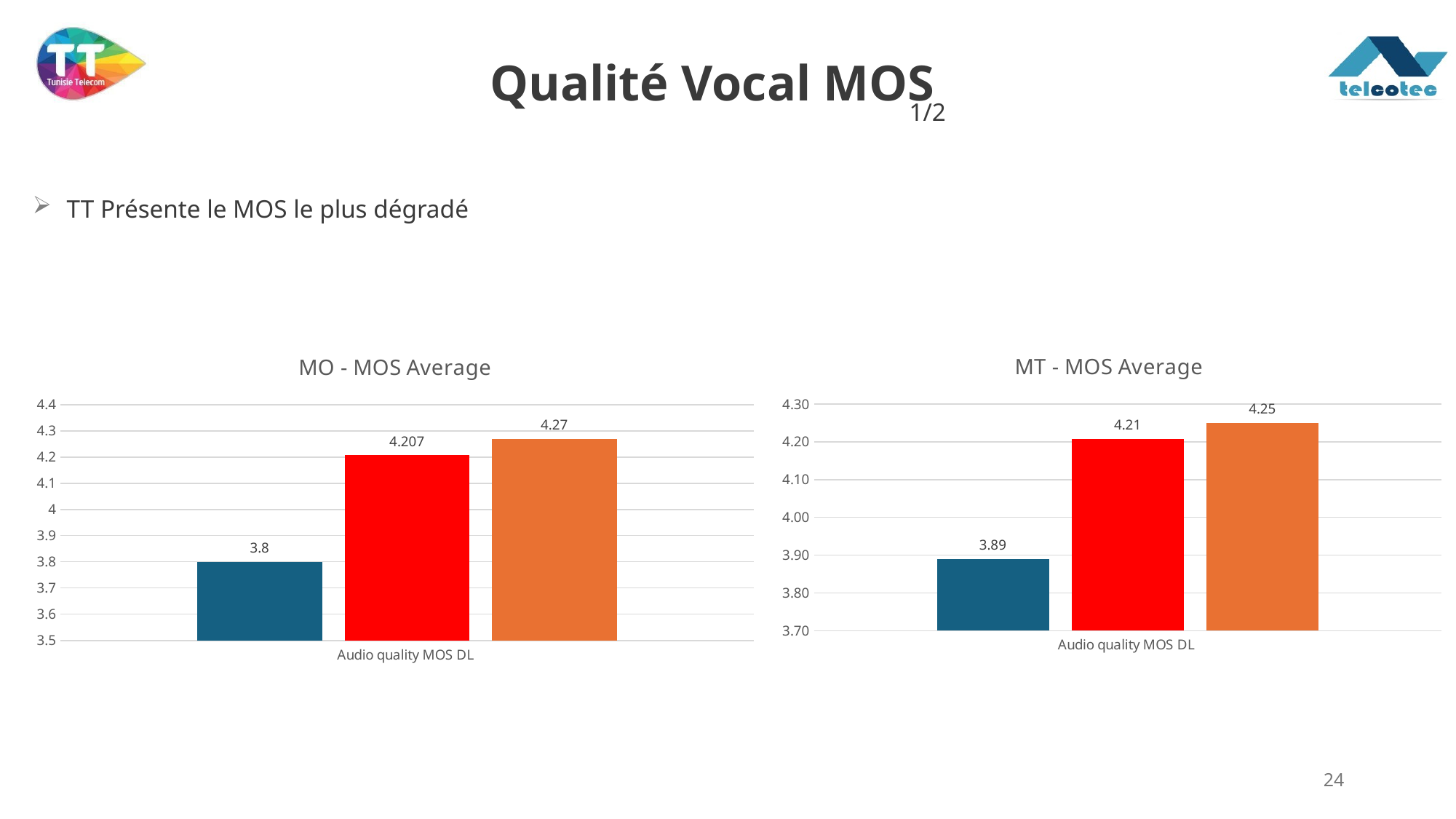
In the 'MT - MOS Average' chart, what is the difference between the red bar and the blue bar? 0.32 In the 'MO - MOS Average' chart, what value is shown on the blue bar? 3.8 How many bars are plotted in the 'MO - MOS Average' chart? 3 In the 'MT - MOS Average' chart, which bar has the highest value? the orange bar In the 'MT - MOS Average' chart, is the blue bar's value greater or less than 4.00? less What type of chart is the 'MT - MOS Average' chart? bar chart In the 'MO - MOS Average' chart, which bar has the lowest value? the blue bar In the 'MT - MOS Average' chart, what value is shown on the orange bar? 4.25 In the 'MO - MOS Average' chart, what is the difference between the orange bar and the blue bar? 0.47 In the 'MT - MOS Average' chart, what value is shown on the blue bar? 3.89 In the 'MO - MOS Average' chart, what value is shown on the red bar? 4.207 In the 'MO - MOS Average' chart, what value is shown on the orange bar? 4.27